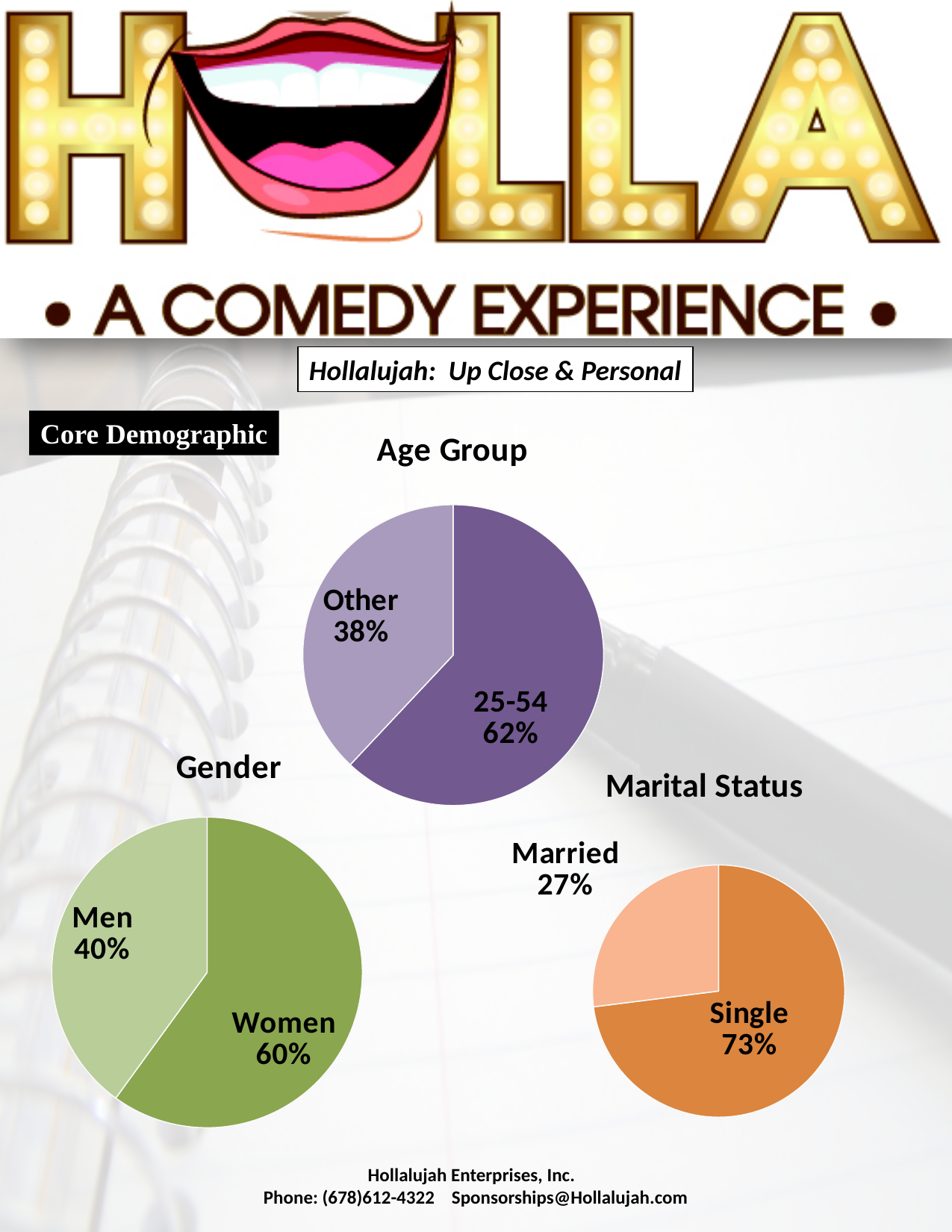
What kind of chart is the Gender chart? Pie chart How many slices does the Age Group chart have? 2 In the Age Group chart, what share of the pie is the 25-54 slice? 62% In the Age Group chart, what share of the pie is the Other slice? 38% In the Age Group chart, what is the difference between the 25-54 and Other slices? 24% In the Marital Status chart, what is the value for Single? 73% In the Marital Status chart, which category is the largest? Single In the Gender chart, what is the value for Men? 40% In the Marital Status chart, what is the value for Married? 27% In the Marital Status chart, what is the difference between Single and Married? 46% In the Gender chart, what is the value for Women? 60% In the Gender chart, which category is the smallest? Men